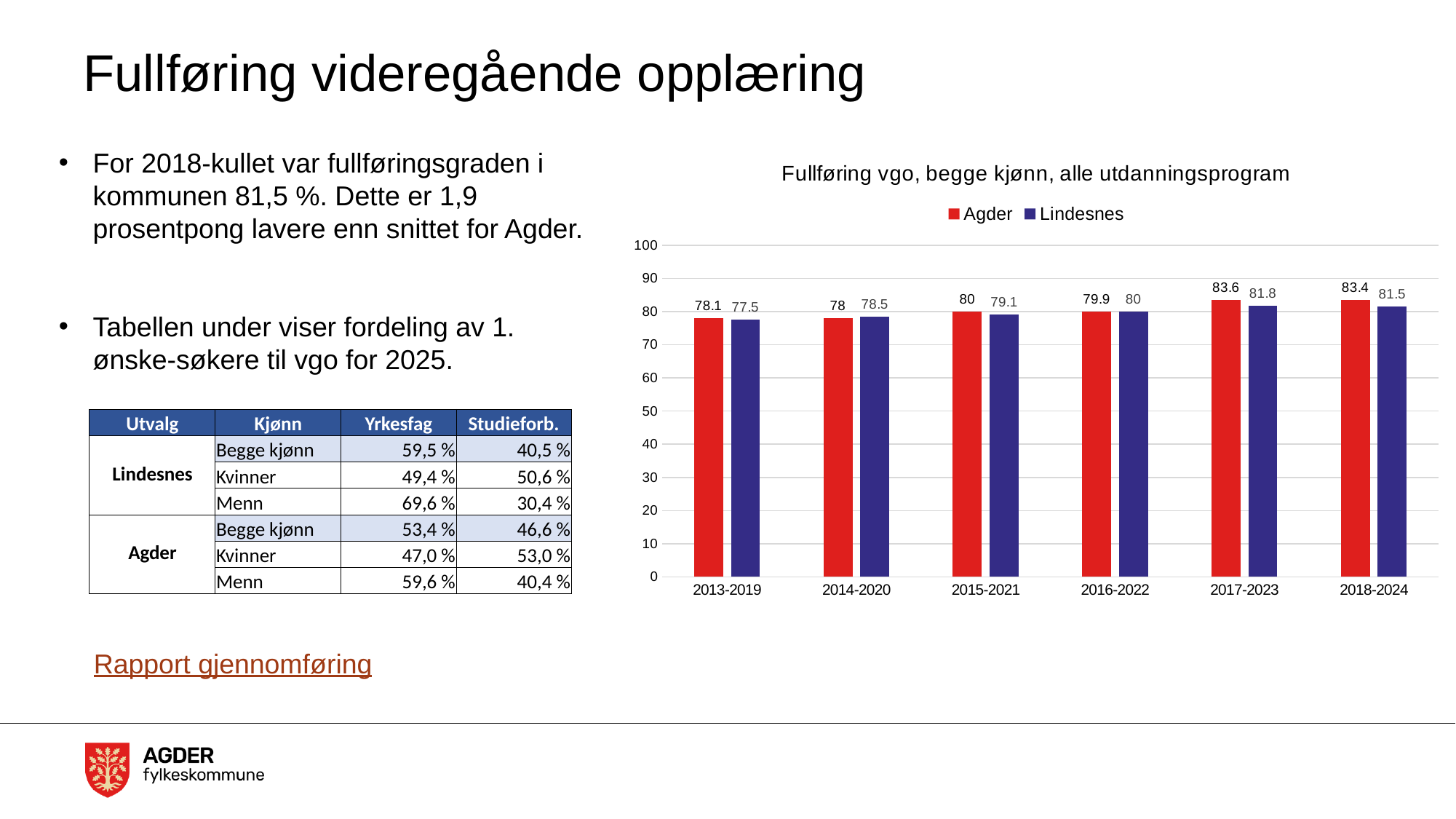
What is the value for Agder in 2018-2024? 83.4 How many periods are shown on the x axis? 6 What kind of chart is shown? Bar chart In which period is the Agder value highest? 2017-2023 In which period is the Lindesnes value lowest? 2013-2019 What is the value for Agder in 2015-2021? 80 What is the value for Lindesnes in 2013-2019? 77.5 What is the value for Lindesnes in 2017-2023? 81.8 What colour are the Lindesnes bars? Blue What is the difference between Agder and Lindesnes in 2018-2024? 1.9 How many series does the legend list? 2 Which is larger in 2014-2020, Agder or Lindesnes? Lindesnes